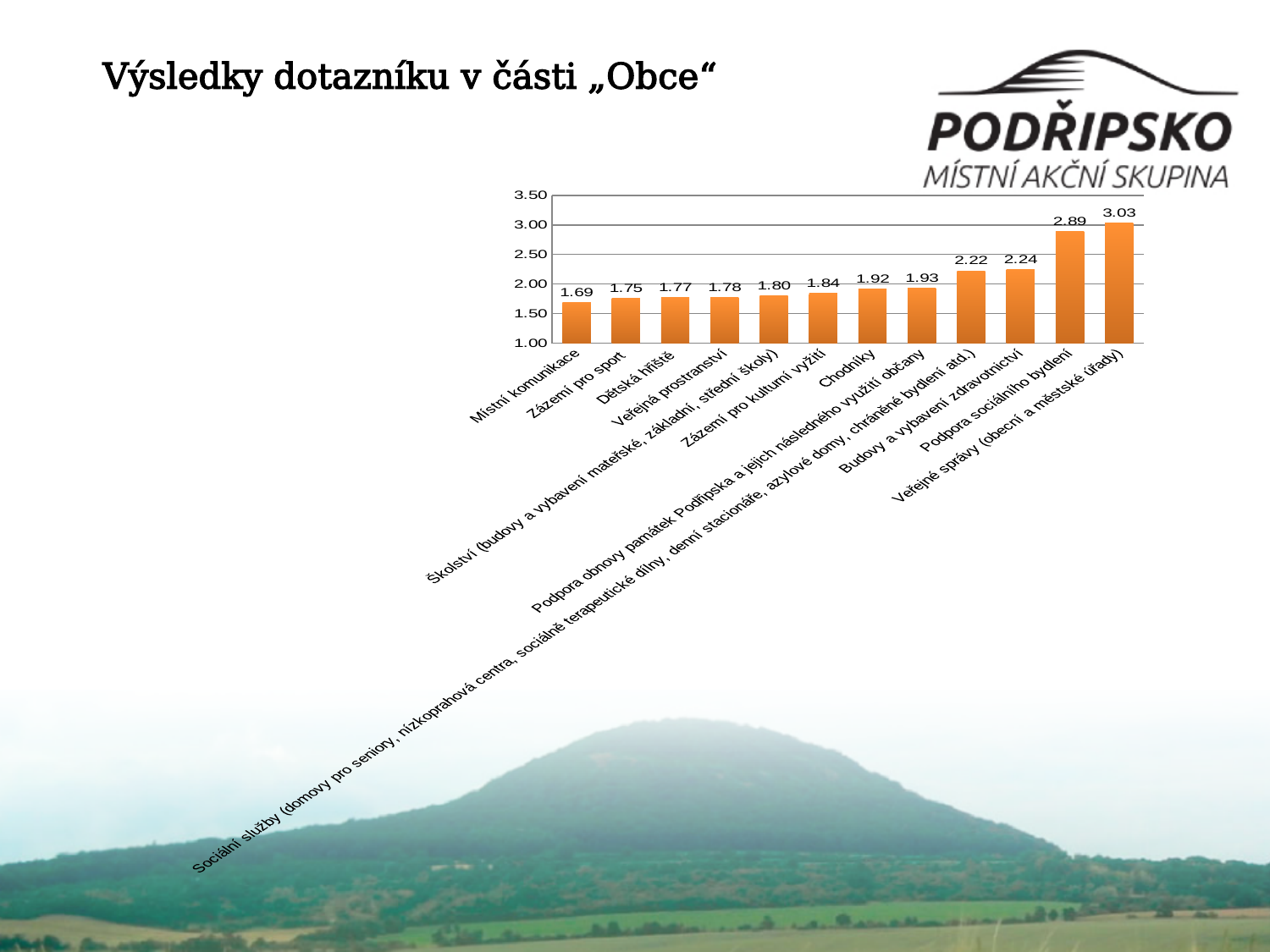
What is the value for Budovy a vybavení zdravotnictví? 2.24 What kind of chart is shown on the slide? bar chart Is the value for Zázemí pro kulturní vyžití greater or less than 2.00? less What is the value for Podpora sociálního bydlení? 2.89 What is the value for Chodníky? 1.92 What is the value for Místní komunikace? 1.69 Which is larger, the value for Chodníky or the value for Dětská hřiště? Chodníky How many categories are shown in the chart? 12 What is the difference between the values for Veřejné správy (obecní a městské úřady) and Podpora sociálního bydlení? 0.14 Which category has the lowest value? Místní komunikace Which category has the highest value? Veřejné správy (obecní a městské úřady) Do the values rise or fall from left to right along the x axis? rise